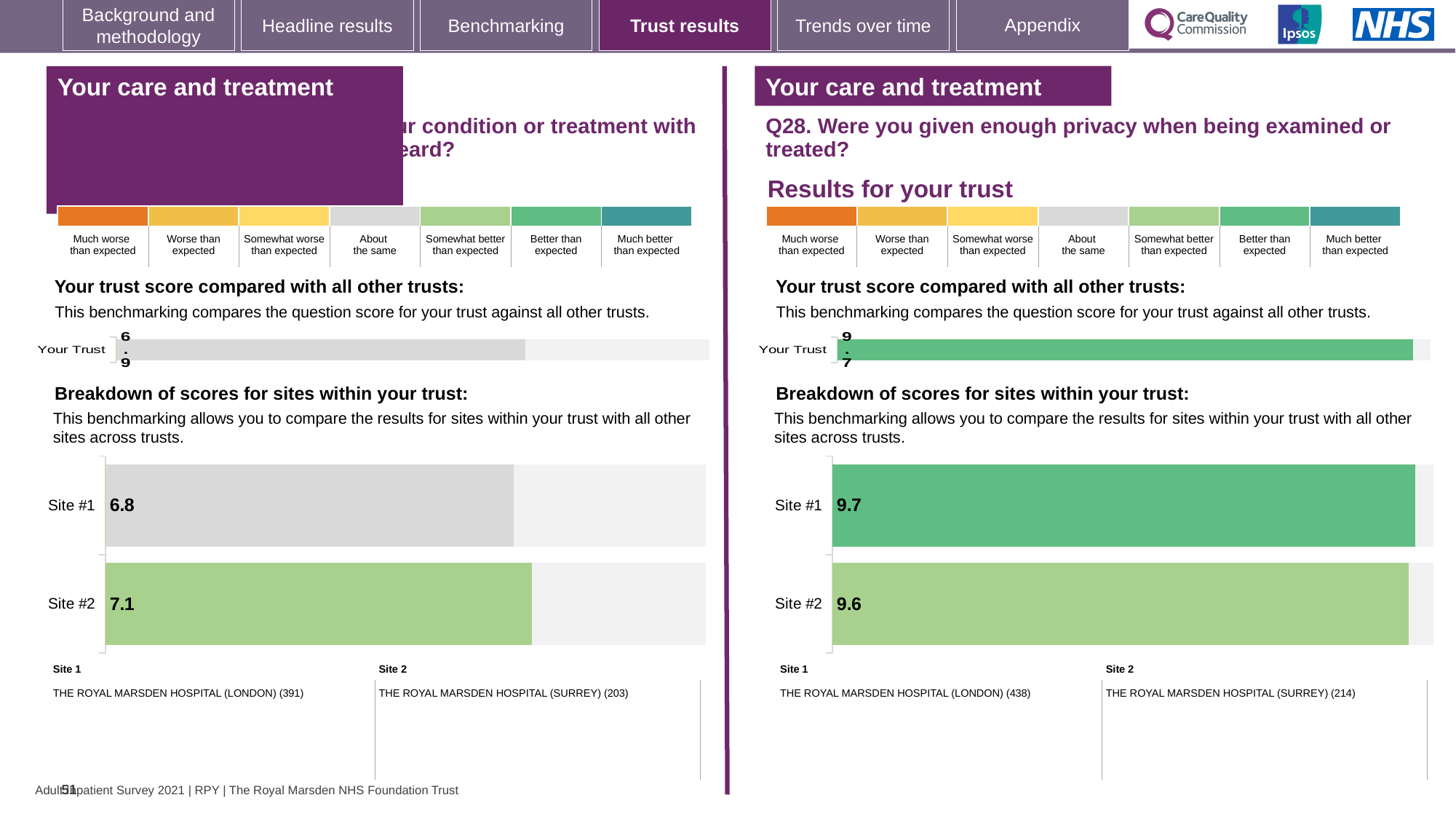
On the left-hand chart of site scores, which site has the higher score? Site #2 On the right-hand chart for Q28, what is the score for Site #2? 9.6 What type of chart is used for the site breakdown on the right-hand side of the slide? Bar chart On the right-hand chart for Q28, which site has the lower score? Site #2 On the right-hand chart for Q28, what is the score for Site #1? 9.7 On the left-hand chart of site scores, what is the difference between the Site #2 and Site #1 scores? 0.3 On the left-hand 'Your trust score compared with all other trusts' chart, what is the score shown for Your Trust? 6.9 On the left-hand chart of site scores, what is the score for Site #2? 7.1 On the right-hand chart for Q28, what is the difference between the Site #1 and Site #2 scores? 0.1 On the right-hand 'Your trust score compared with all other trusts' chart for Q28, what is the score shown for Your Trust? 9.7 How many sites are shown in the right-hand site breakdown chart for Q28? 2 On the left-hand chart of site scores, what is the score for Site #1? 6.8